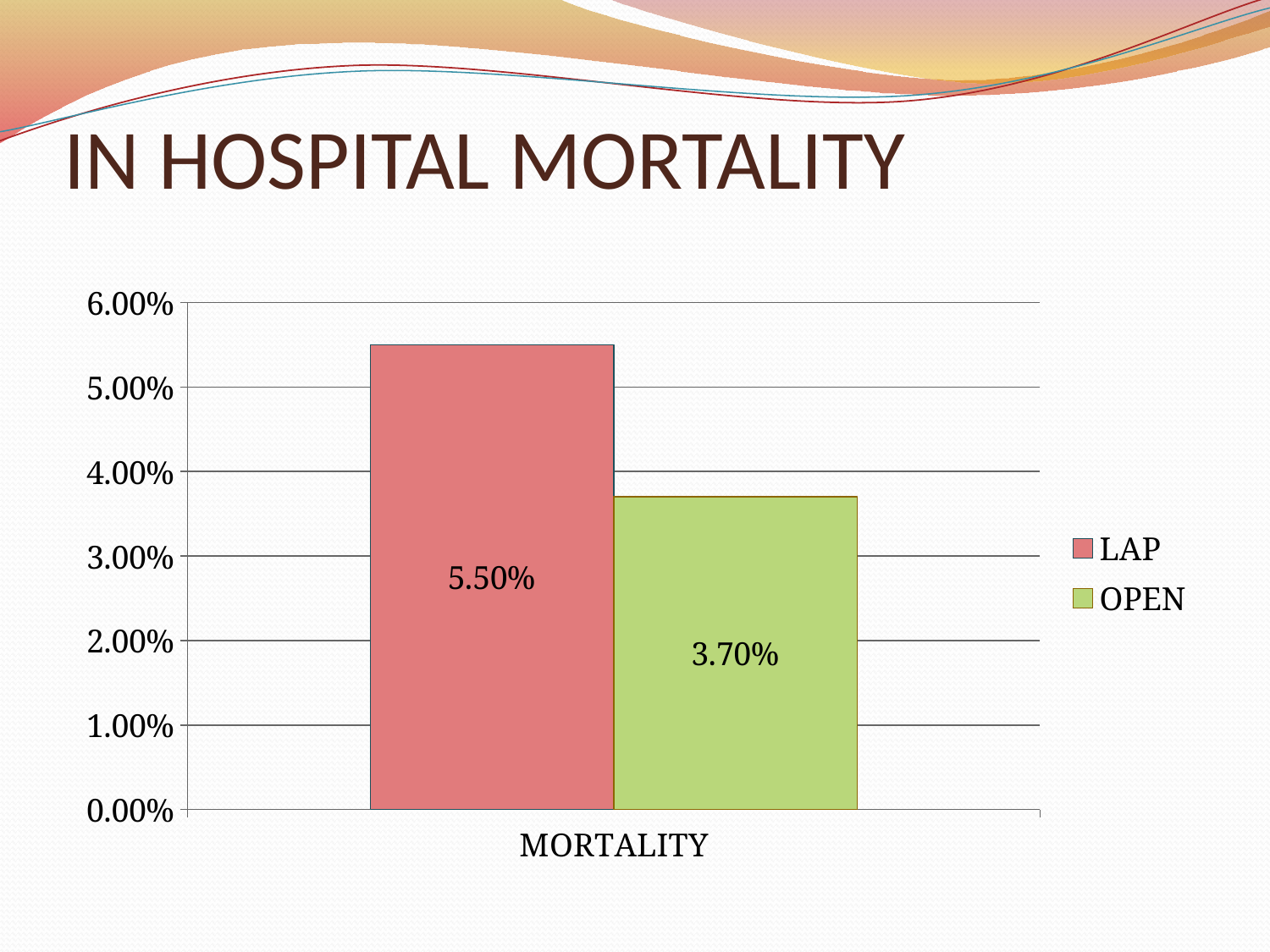
Is the mortality value for OPEN greater or less than 4.00%? less Which series has the higher mortality, LAP or OPEN? LAP Is the mortality value for LAP greater or less than 5.00%? greater What is the difference between the LAP and OPEN mortality values? 1.80% What is the category label on the x axis? MORTALITY What is the mortality value for OPEN? 3.70% How many series does the legend list? 2 Which series has the highest mortality? LAP What colour is the bar for OPEN? Green What is the mortality value for LAP? 5.50% Which series has the lowest mortality? OPEN What kind of chart is shown on the slide? Bar chart